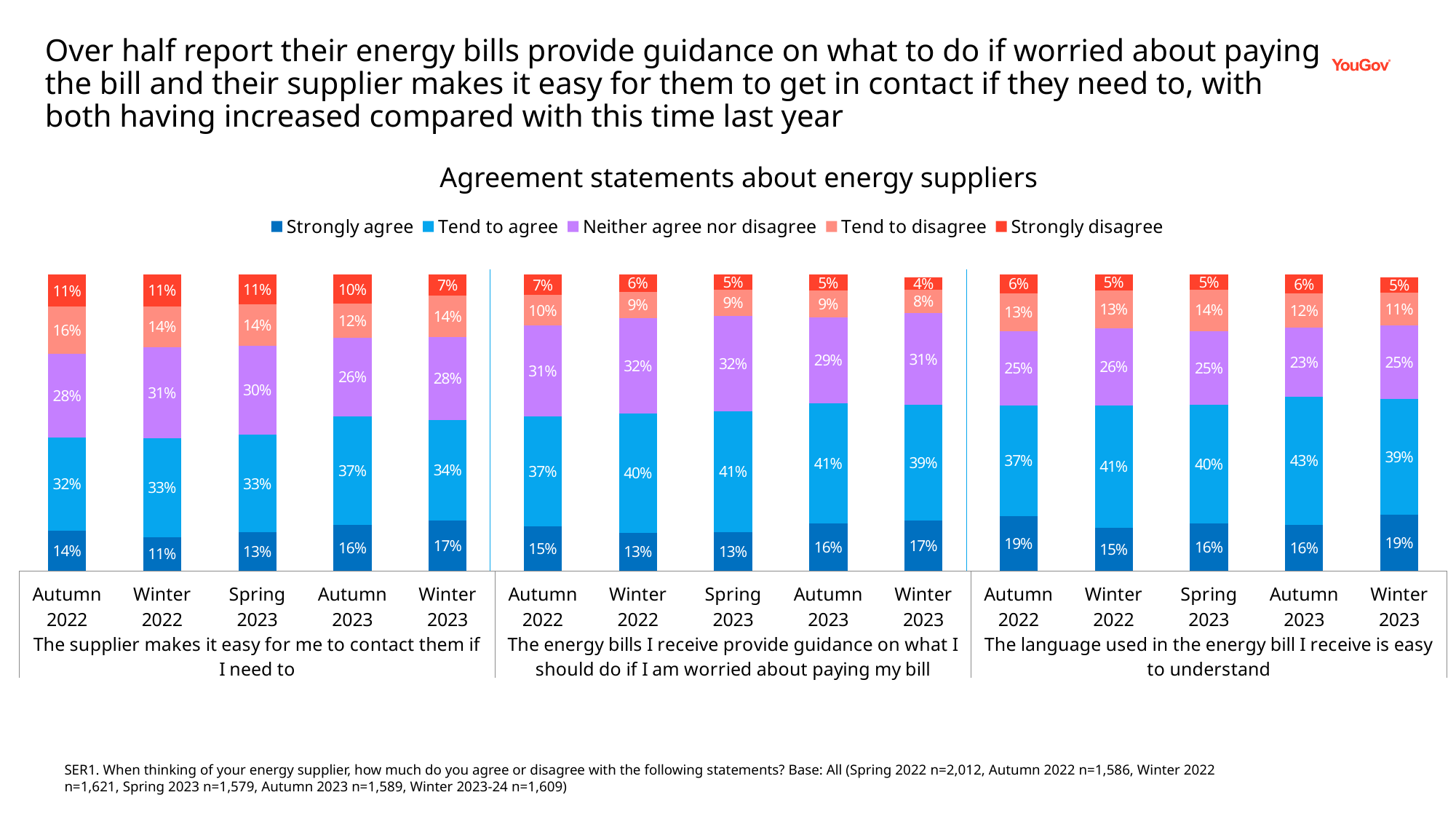
How many series does the legend list? 5 What is the 'Strongly disagree' value for Winter 2023 under 'The energy bills I receive provide guidance on what I should do if I am worried about paying my bill'? 4% What is the 'Tend to agree' value for Autumn 2023 under 'The language used in the energy bill I receive is easy to understand'? 43% What is the title of the chart? Agreement statements about energy suppliers Which is larger: the 'Tend to agree' value for Spring 2023 under 'The energy bills I receive provide guidance...' or the 'Tend to agree' value for Spring 2023 under 'The supplier makes it easy for me to contact them if I need to'? The energy bills I receive provide guidance (41%) Under 'The supplier makes it easy for me to contact them if I need to', which period has the lowest 'Strongly agree' value? Winter 2022 What is the 'Neither agree nor disagree' value for Winter 2022 under 'The supplier makes it easy for me to contact them if I need to'? 31% What kind of chart is shown on the slide? Stacked bar chart How many bars are plotted in the chart in total? 15 Under 'The language used in the energy bill I receive is easy to understand', which period has the highest 'Tend to agree' value? Autumn 2023 What is the difference between the 'Strongly disagree' values for Autumn 2022 and Winter 2023 under 'The supplier makes it easy for me to contact them if I need to'? 4 percentage points What is the 'Strongly agree' value for Winter 2023 under 'The supplier makes it easy for me to contact them if I need to'? 17%